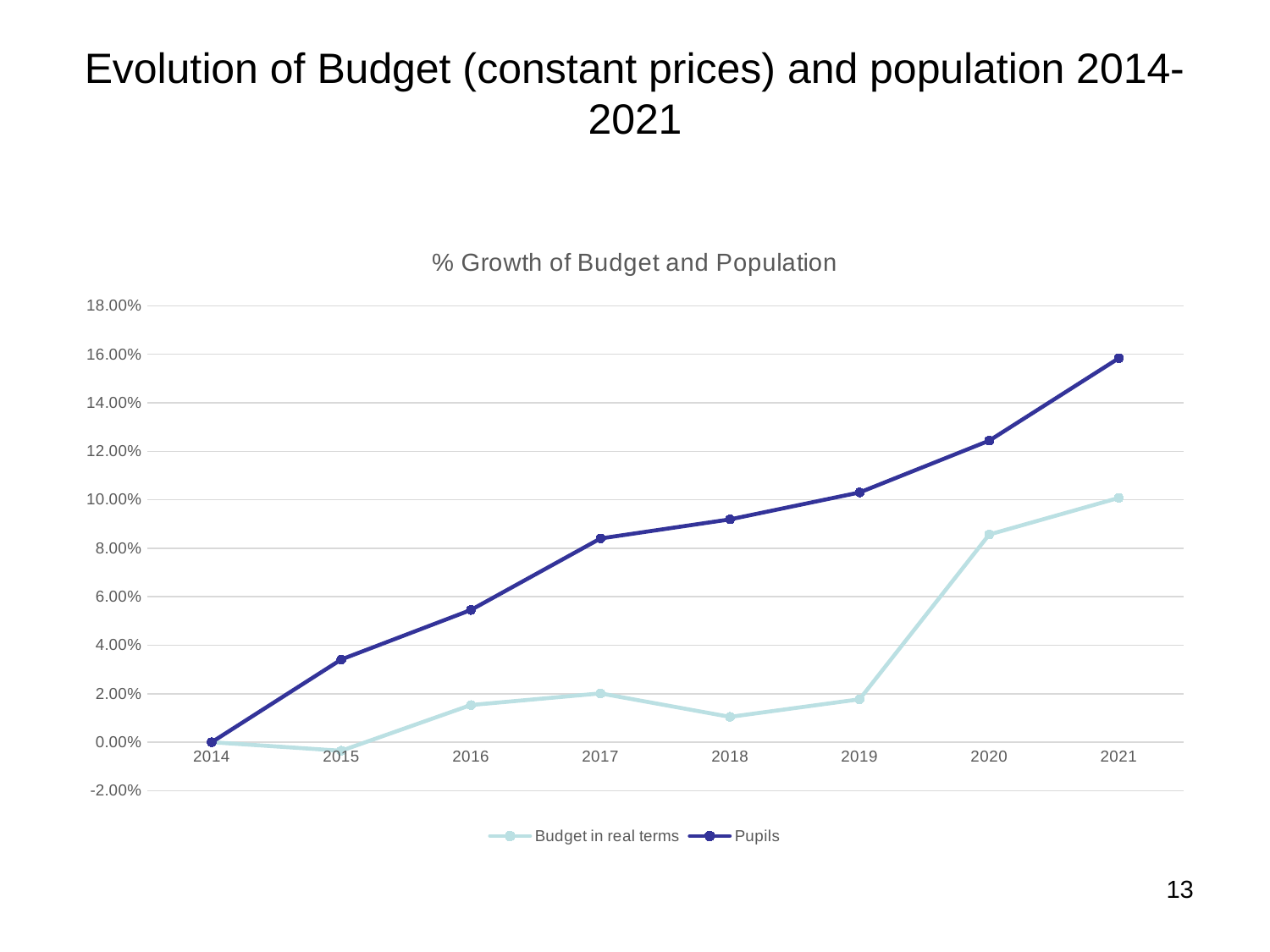
How many years are plotted along the x axis? 8 Is the value for Pupils in 2021 greater or less than 14.00%? greater In which year does the Pupils series reach its highest value? 2021 Is the value for Pupils in 2015 greater or less than 2.00%? greater In which year does the Budget in real terms series reach its highest value? 2021 Does the Pupils series rise or fall from 2014 to 2021? rise What is the title of the chart? % Growth of Budget and Population How many series does the legend list? 2 Is the value for Budget in real terms in 2018 greater or less than 2.00%? less What kind of chart is shown on the slide? line chart Which series is drawn in dark blue? Pupils In 2019, which series has the larger value, Pupils or Budget in real terms? Pupils